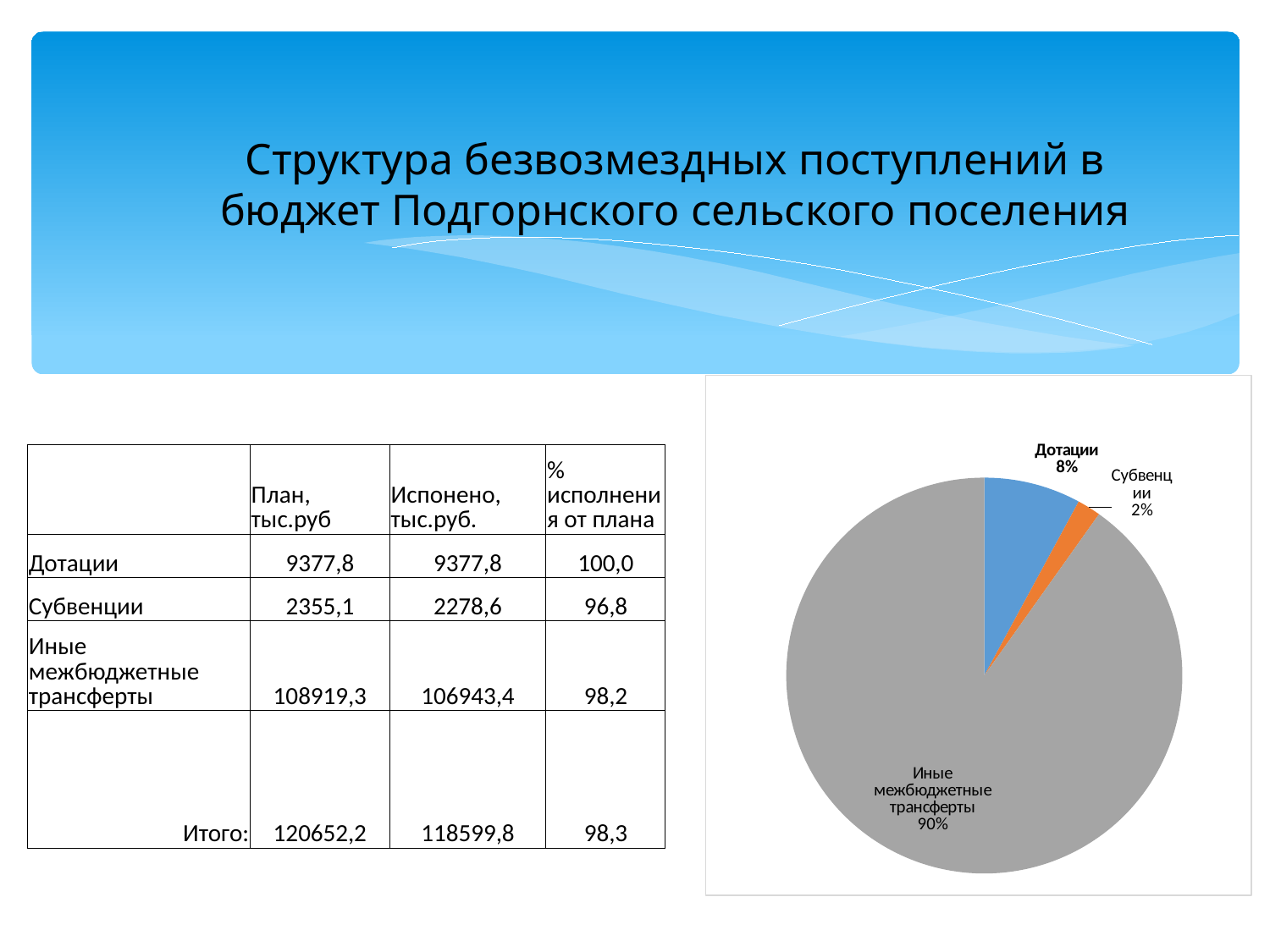
In the pie chart, what is the difference in percentage points between Иные межбюджетные трансферты and Дотации? 82% What kind of chart is shown on the slide? pie chart How many slices does the pie chart have? 3 Which slice of the pie chart is the largest? Иные межбюджетные трансферты What colour is the Иные межбюджетные трансферты slice in the pie chart? grey What share of the pie chart is labelled Субвенции? 2% In the pie chart, what is the difference in percentage points between Дотации and Субвенции? 6% In the pie chart, which is larger: Дотации or Субвенции? Дотации What share of the pie chart is labelled Иные межбюджетные трансферты? 90% Which slice of the pie chart is the smallest? Субвенции What share of the pie chart is labelled Дотации? 8% What colour is the Субвенции slice in the pie chart? orange